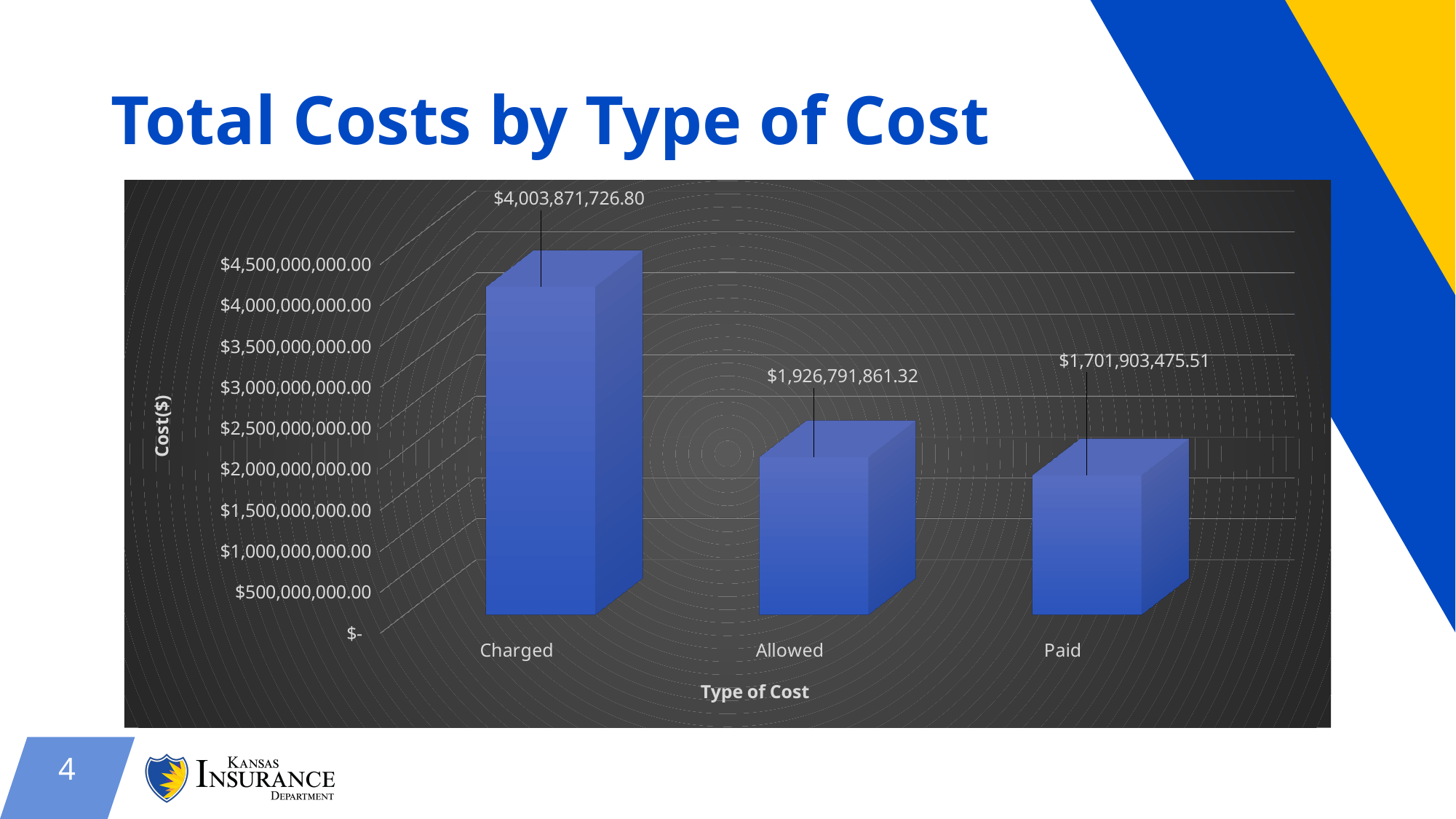
What is the difference between the Charged and Allowed values? $2,077,079,865.48 Which is larger, the value for Allowed or the value for Paid? Allowed Is the value for Charged greater or less than $3,500,000,000.00? greater How many types of cost are shown on the chart? 3 What is the difference between the Allowed and Paid values? $224,888,385.81 Which type of cost has the lowest total? Paid Which type of cost has the highest total? Charged What is the value for Paid? $1,701,903,475.51 What kind of chart is shown on the slide? Bar chart What is the value for Charged? $4,003,871,726.80 What is the value for Allowed? $1,926,791,861.32 What is the label of the vertical axis? Cost($)